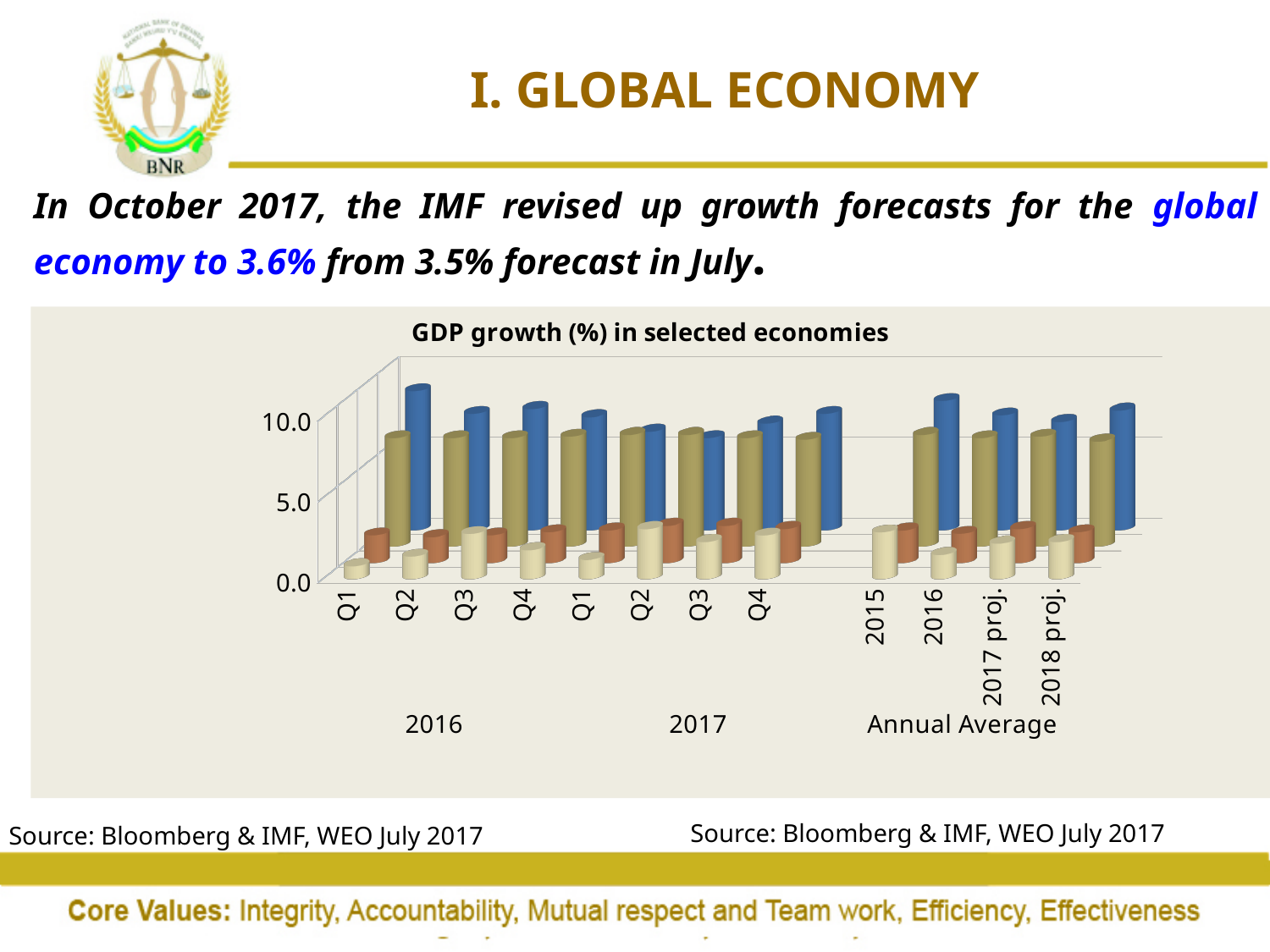
Is the value of the cream (lightest) bar for Q1 2016 greater or less than 5.0? less What is the title of the chart? GDP growth (%) in selected economies Among the blue bars, which category has the highest value? Q1 2016 In Q4 2017, which is larger: the olive bar or the orange bar? the olive bar How many categories are in the Annual Average group of the chart? 4 How many groups (2016, 2017, Annual Average) are labelled along the x axis? 3 In Q1 2016, which is larger: the blue bar or the cream bar? the blue bar What kind of chart is shown on the slide? bar chart How many categories are shown along the x axis of the chart? 12 Is the value of the blue bar for Q2 2016 greater or less than 5.0? greater Is the value of the orange bar for Q4 2017 greater or less than 5.0? less What source is cited below the chart? Bloomberg & IMF, WEO July 2017